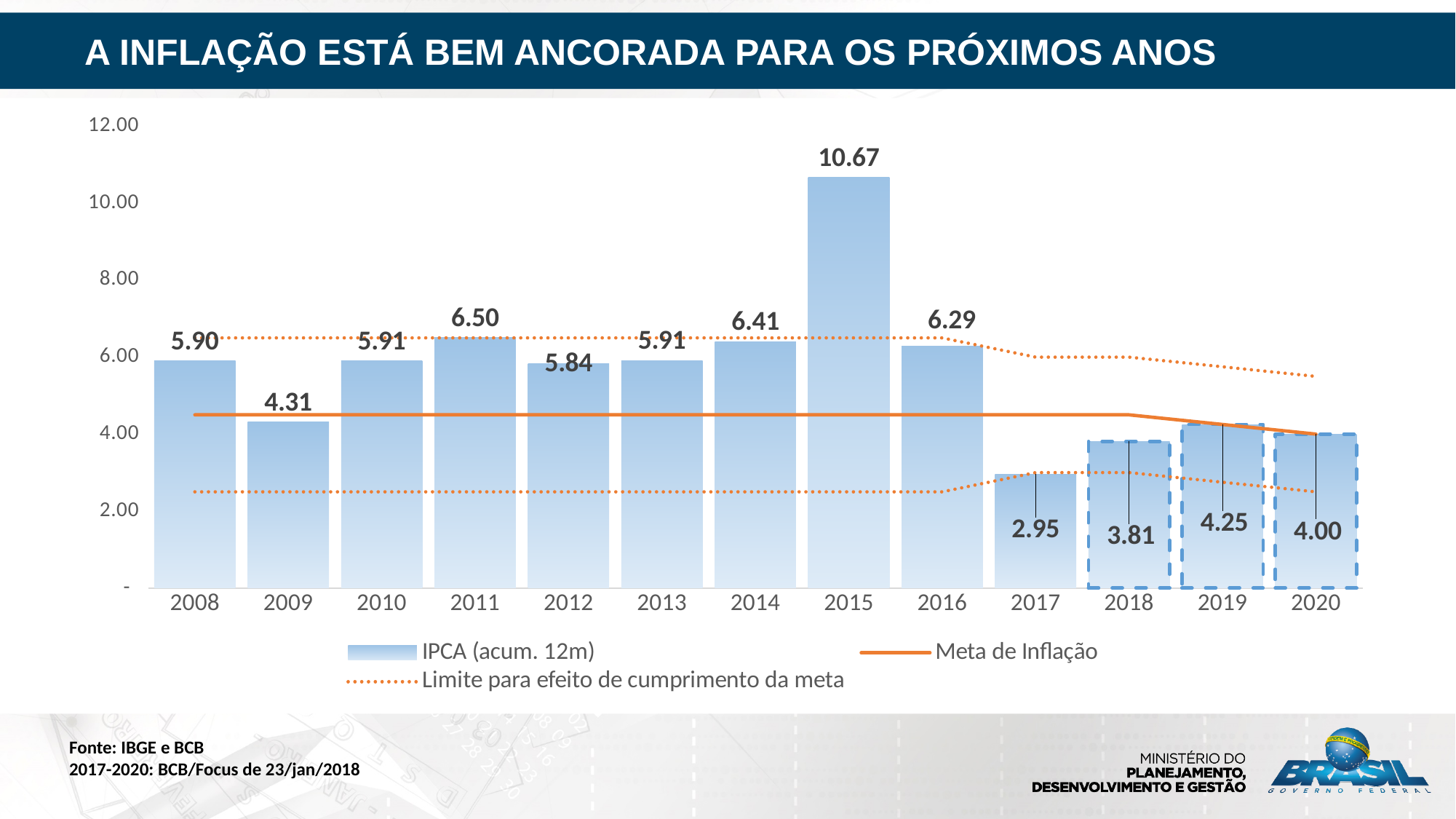
Which year has the lowest IPCA (acum. 12m) value? 2017 Which year has the highest IPCA (acum. 12m) value? 2015 How many years are shown on the x axis? 13 What is the IPCA (acum. 12m) value for 2017? 2.95 What is the IPCA (acum. 12m) value for 2015? 10.67 Is the Meta de Inflação value for 2012 greater or less than 4.00? greater What is the IPCA (acum. 12m) value for 2020? 4.00 Which year has a larger IPCA (acum. 12m) value, 2011 or 2014? 2011 How many series does the legend list? 3 What is the difference between the IPCA (acum. 12m) values for 2015 and 2016? 4.38 What kind of chart is used to show the IPCA (acum. 12m) series? bar chart Do the IPCA (acum. 12m) values rise or fall from 2017 to 2019? rise